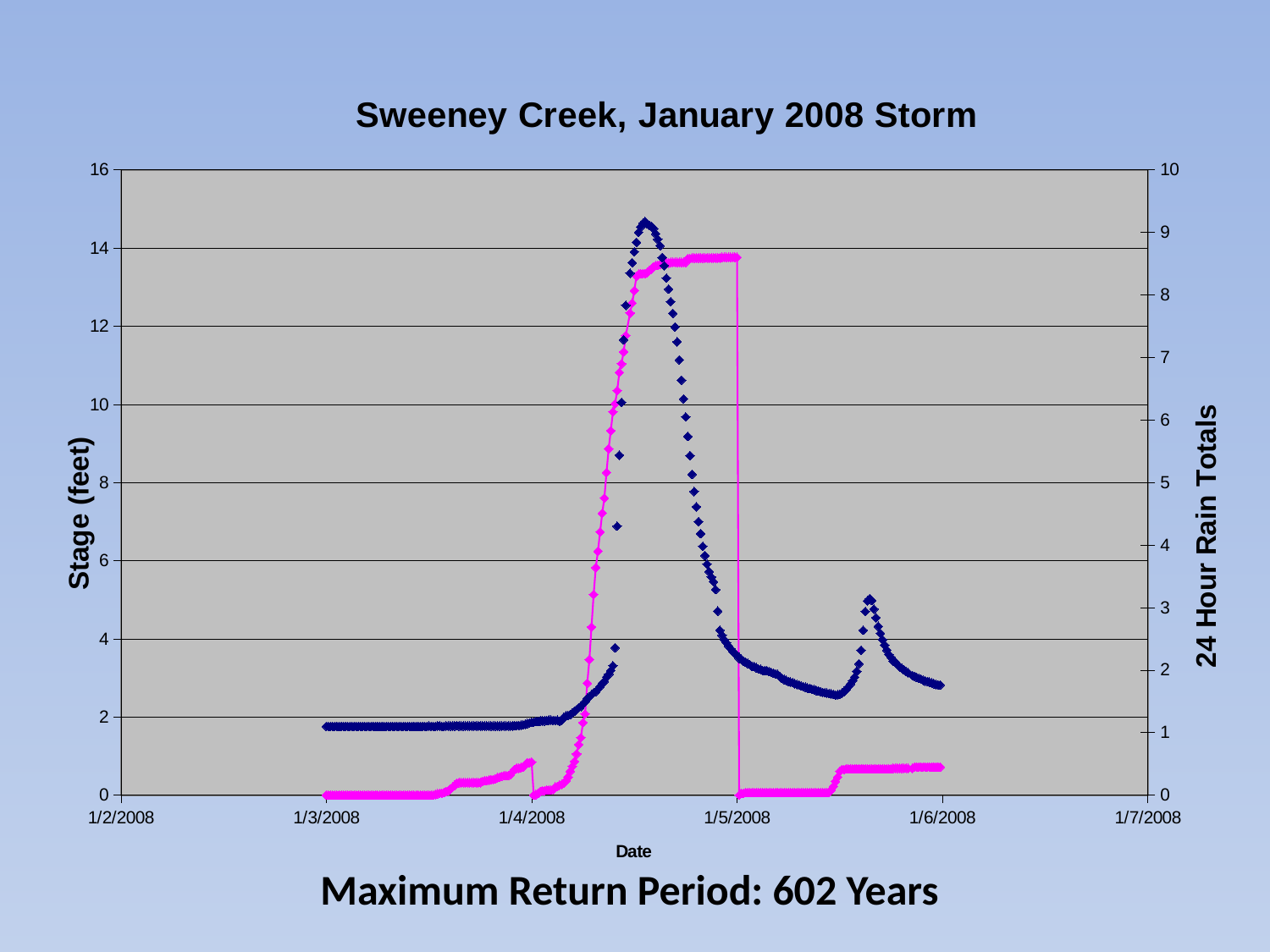
What type of chart is shown on the slide? Scatter (line) chart What is the maximum value shown on the left vertical axis? 16 Is the stage value on 1/3/2008 greater or less than 2 feet? less What is the label of the left vertical axis? Stage (feet) Is the peak value of the dark blue stage series greater or less than 14 feet? greater What is the label of the right vertical axis? 24 Hour Rain Totals Does the stage series rise or fall between 1/4/2008 and its peak before 1/5/2008? rise Is the second, smaller peak of the stage series (between 1/5/2008 and 1/6/2008) greater or less than 4 feet? greater How many data series are plotted on the chart? 2 How many date labels are shown on the x axis? 6